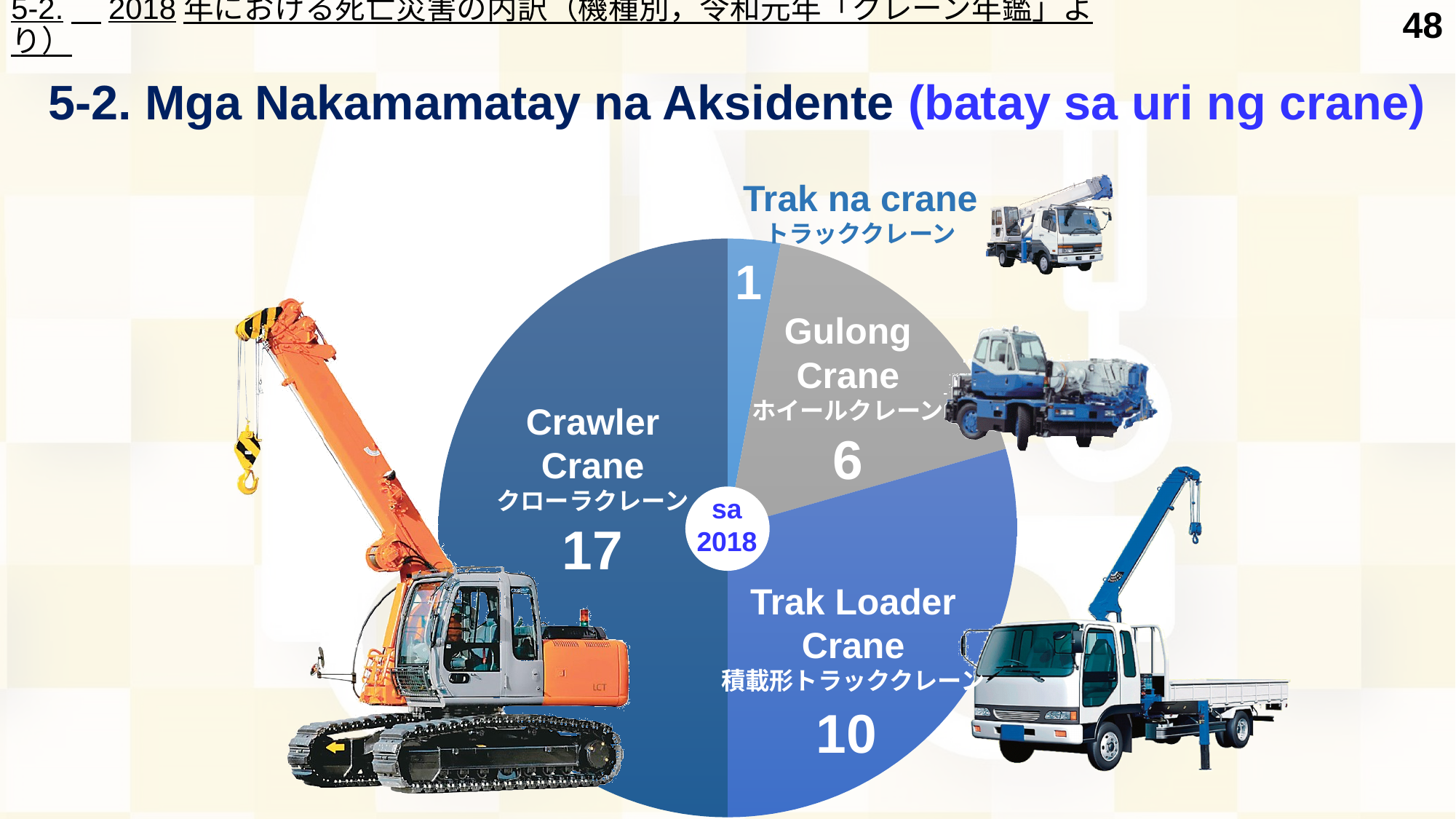
What value is shown for Trak Loader Crane in the pie chart? 10 What value is shown for Gulong Crane in the pie chart? 6 What is the total of all values shown in the pie chart? 34 Which crane type has the smallest slice in the pie chart? Trak na crane What share of the pie does the Crawler Crane slice represent? 50% What value is shown for Trak na crane in the pie chart? 1 What is the difference between the values for Crawler Crane and Trak Loader Crane? 7 How many crane types (slices) are shown in the pie chart? 4 Which is larger in the pie chart, Gulong Crane or Trak Loader Crane? Trak Loader Crane What kind of chart is shown on the slide? pie chart How many fatal accidents are attributed to Crawler Crane in the pie chart? 17 Which crane type has the largest slice in the pie chart? Crawler Crane